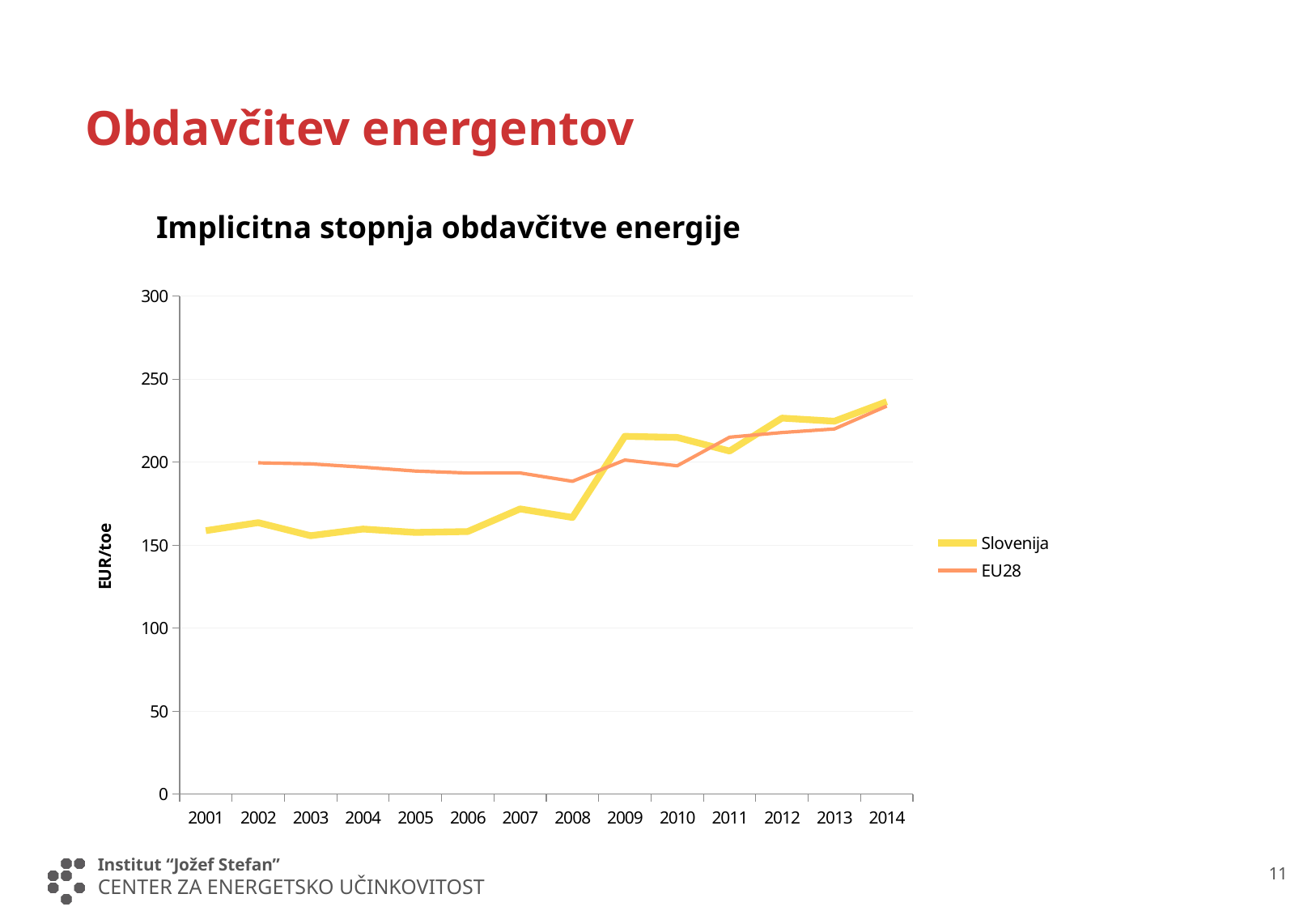
How many series does the legend list? 2 Is the value for Slovenija in 2009 greater or less than 200? greater How many years are shown on the x axis? 14 In 2009, which series has the higher value, Slovenija or EU28? Slovenija Is the value for EU28 in 2008 greater or less than 200? less In 2005, which series has the higher value, Slovenija or EU28? EU28 Is the value for Slovenija in 2001 greater or less than 200? less What kind of chart is shown on the slide? line chart What is the title of the chart? Implicitna stopnja obdavčitve energije What unit is shown on the y axis label? EUR/toe Does the Slovenija series rise or fall overall from 2001 to 2014? rise